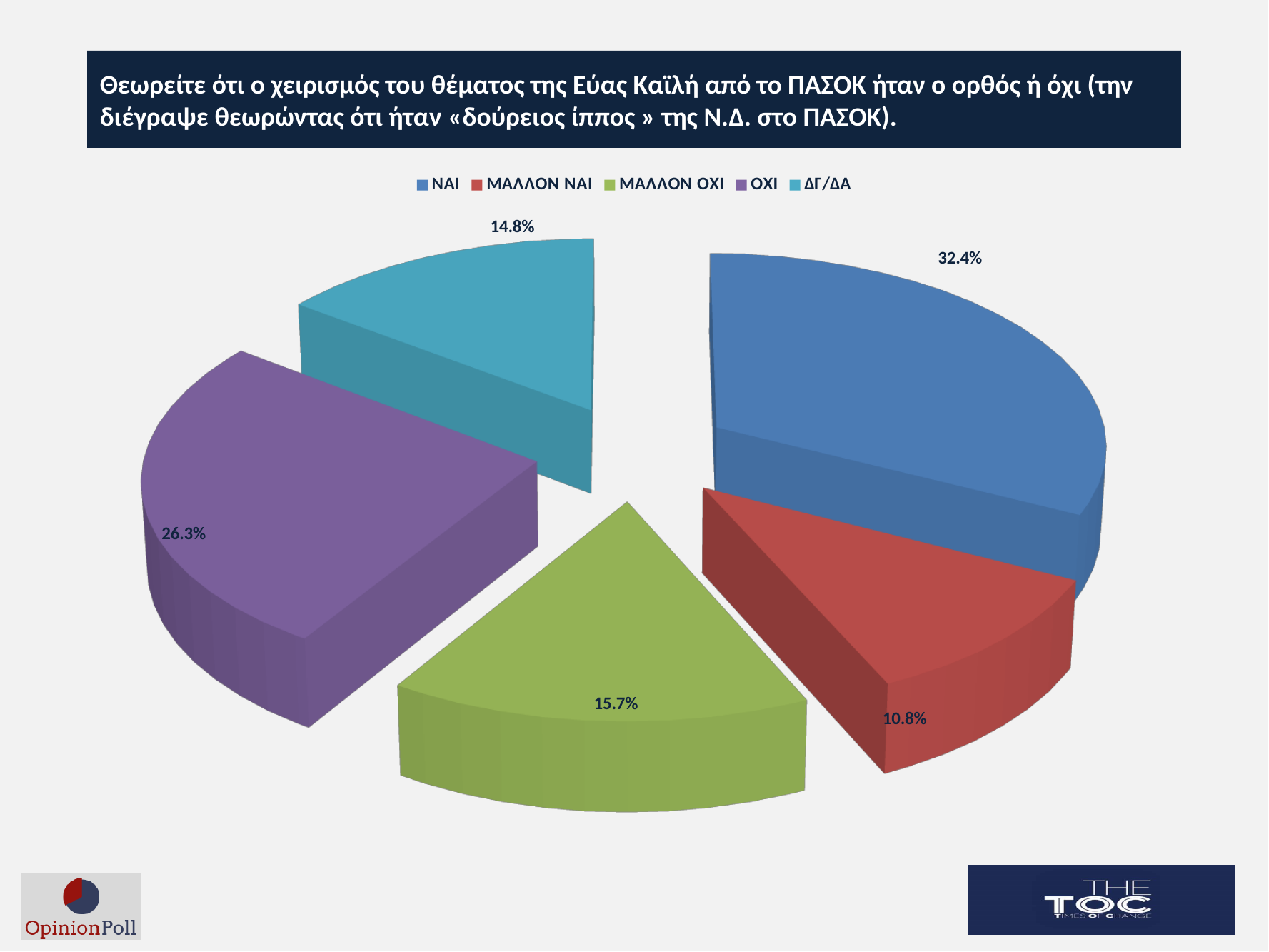
What kind of chart is shown on the slide? Pie chart What percentage of the pie chart is labelled ΜΑΛΛΟΝ ΟΧΙ? 15.7% What percentage of the pie chart is labelled ΟΧΙ? 26.3% What percentage of the pie chart is labelled ΝΑΙ? 32.4% Which is larger, the share for ΜΑΛΛΟΝ ΟΧΙ or the share for ΔΓ/ΔΑ? ΜΑΛΛΟΝ ΟΧΙ Which category has the largest share of the pie chart? ΝΑΙ How many categories does the pie chart show? 5 What percentage of the pie chart is labelled ΔΓ/ΔΑ? 14.8% Which category has the smallest share of the pie chart? ΜΑΛΛΟΝ ΝΑΙ What colour is the ΟΧΙ slice in the pie chart? Purple What percentage of the pie chart is labelled ΜΑΛΛΟΝ ΝΑΙ? 10.8% What is the difference in percentage points between ΝΑΙ and ΟΧΙ? 6.1